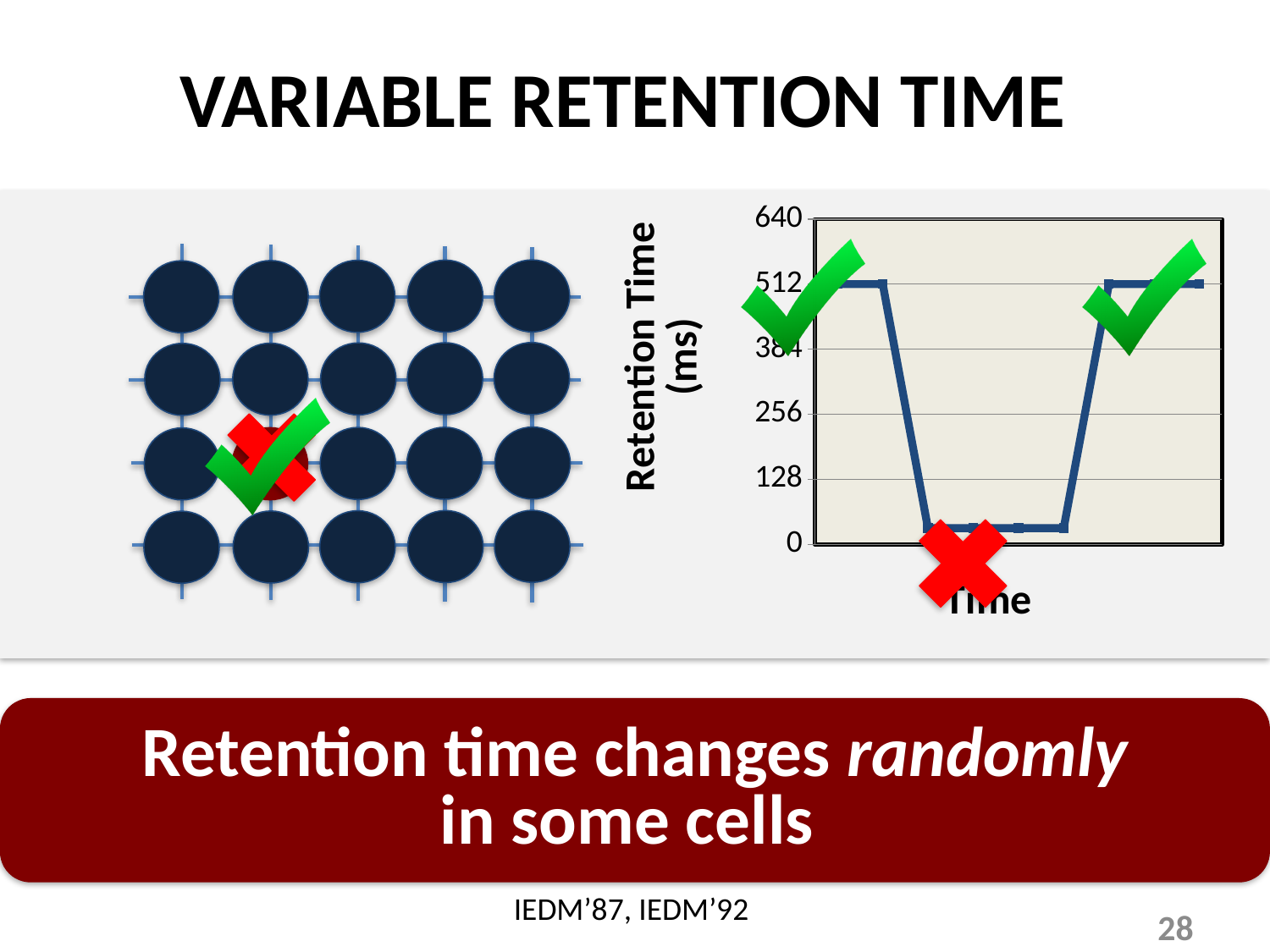
Is the retention time at the end of the chart greater or less than 256? greater Which is larger: the retention time at the start of the chart or the retention time in the middle dip? the start What is the label of the y-axis of the chart? Retention Time (ms) What kind of chart is shown on the right side of the slide? line chart Does the retention time in the middle section of the chart fall below 128? yes What retention time value does the line start at on the left of the chart? 512 What is the label of the x-axis of the chart? Time How does the retention time change along the x axis of the chart? it falls sharply, then rises back up Is the retention time at the start of the chart greater or less than 384? greater What is the highest value shown on the y-axis of the chart? 640